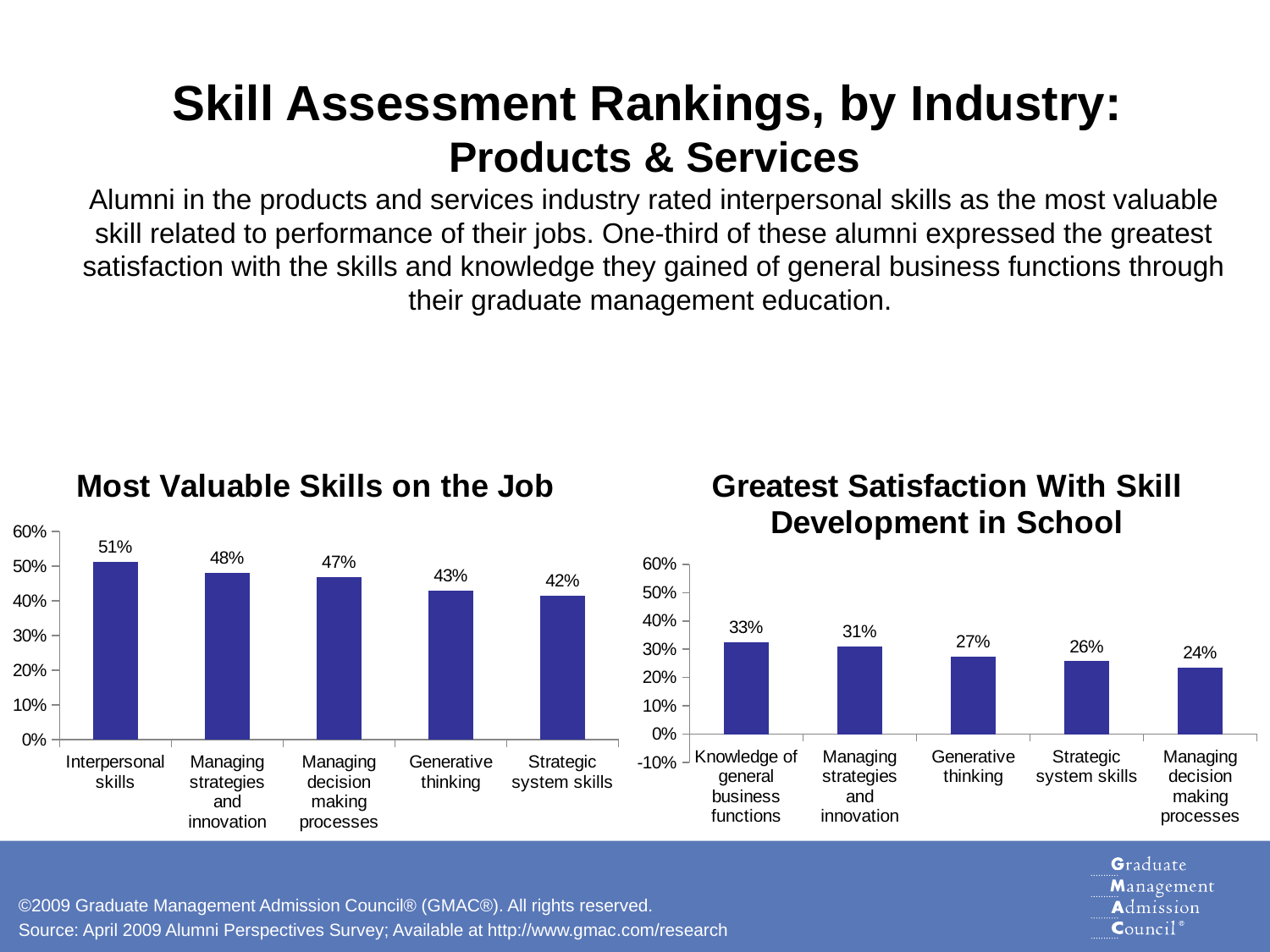
What type of chart is the 'Greatest Satisfaction With Skill Development in School' chart? Bar chart How many categories are shown in the 'Most Valuable Skills on the Job' chart? 5 In the 'Most Valuable Skills on the Job' chart, which category has the lowest value? Strategic system skills In the 'Greatest Satisfaction With Skill Development in School' chart, what is the difference between Managing strategies and innovation and Generative thinking? 4% Which is larger: Managing decision making processes in the 'Most Valuable Skills on the Job' chart or Managing decision making processes in the 'Greatest Satisfaction With Skill Development in School' chart? Most Valuable Skills on the Job In the 'Greatest Satisfaction With Skill Development in School' chart, what is the value for Knowledge of general business functions? 33% In the 'Greatest Satisfaction With Skill Development in School' chart, what is the value for Strategic system skills? 26% In the 'Most Valuable Skills on the Job' chart, what is the value for Generative thinking? 43% In the 'Most Valuable Skills on the Job' chart, what is the value for Interpersonal skills? 51% In the 'Greatest Satisfaction With Skill Development in School' chart, which category has the lowest value? Managing decision making processes In the 'Most Valuable Skills on the Job' chart, what is the difference between Interpersonal skills and Strategic system skills? 9% In the 'Greatest Satisfaction With Skill Development in School' chart, which category has the highest value? Knowledge of general business functions